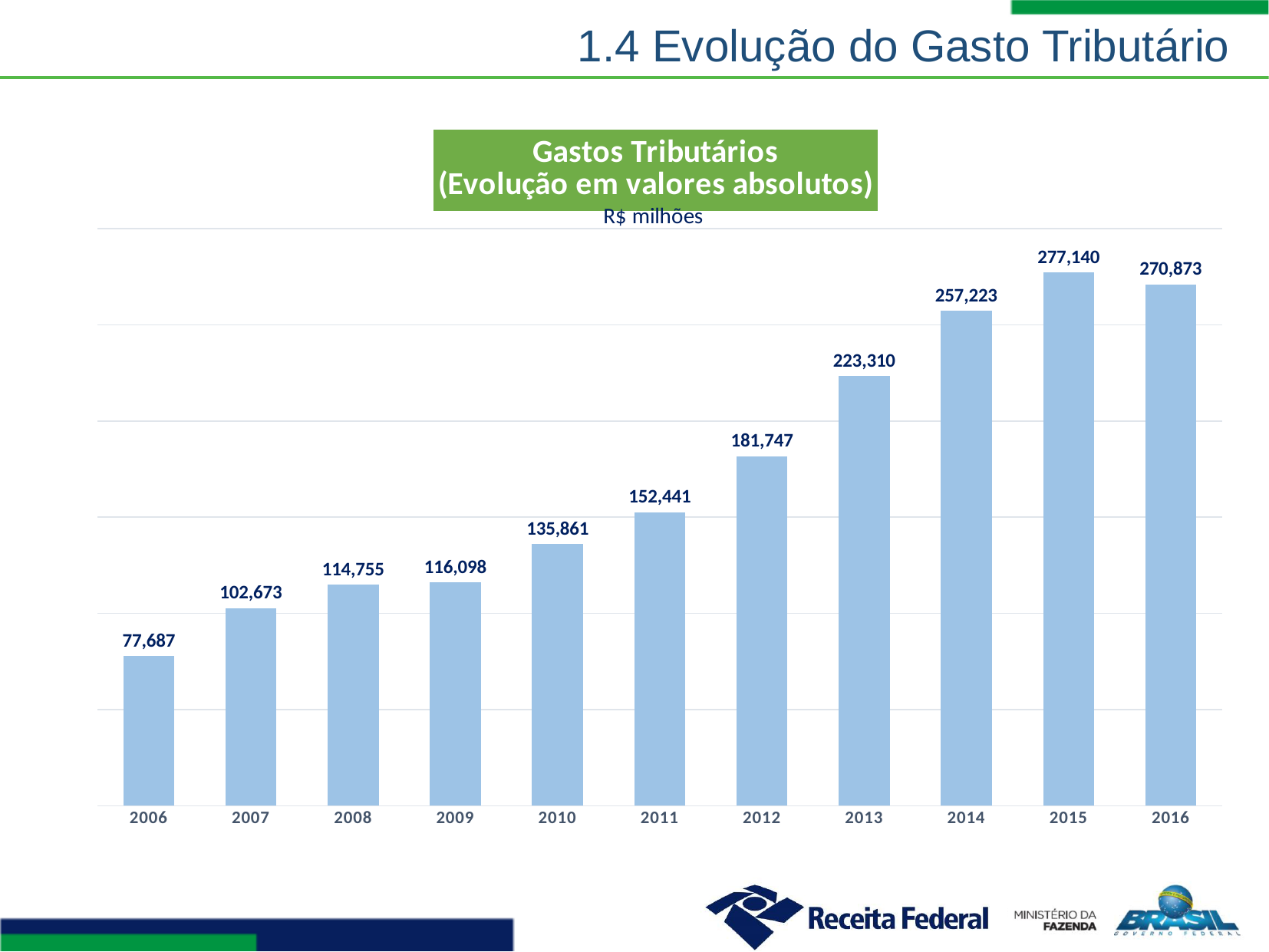
Do the values generally rise or fall from 2006 to 2015? Rise What is the difference between the values for 2016 and 2006? 193,186 What kind of chart is shown? Bar chart What is the value for 2016? 270,873 Which year has the highest value? 2015 Which is larger, the value for 2015 or the value for 2016? 2015 Which year has the lowest value? 2006 What is the value for 2006? 77,687 What is the difference between the values for 2015 and 2016? 6,267 What unit is stated below the chart title? R$ milhões How many years are shown on the x axis? 11 What is the value for 2013? 223,310